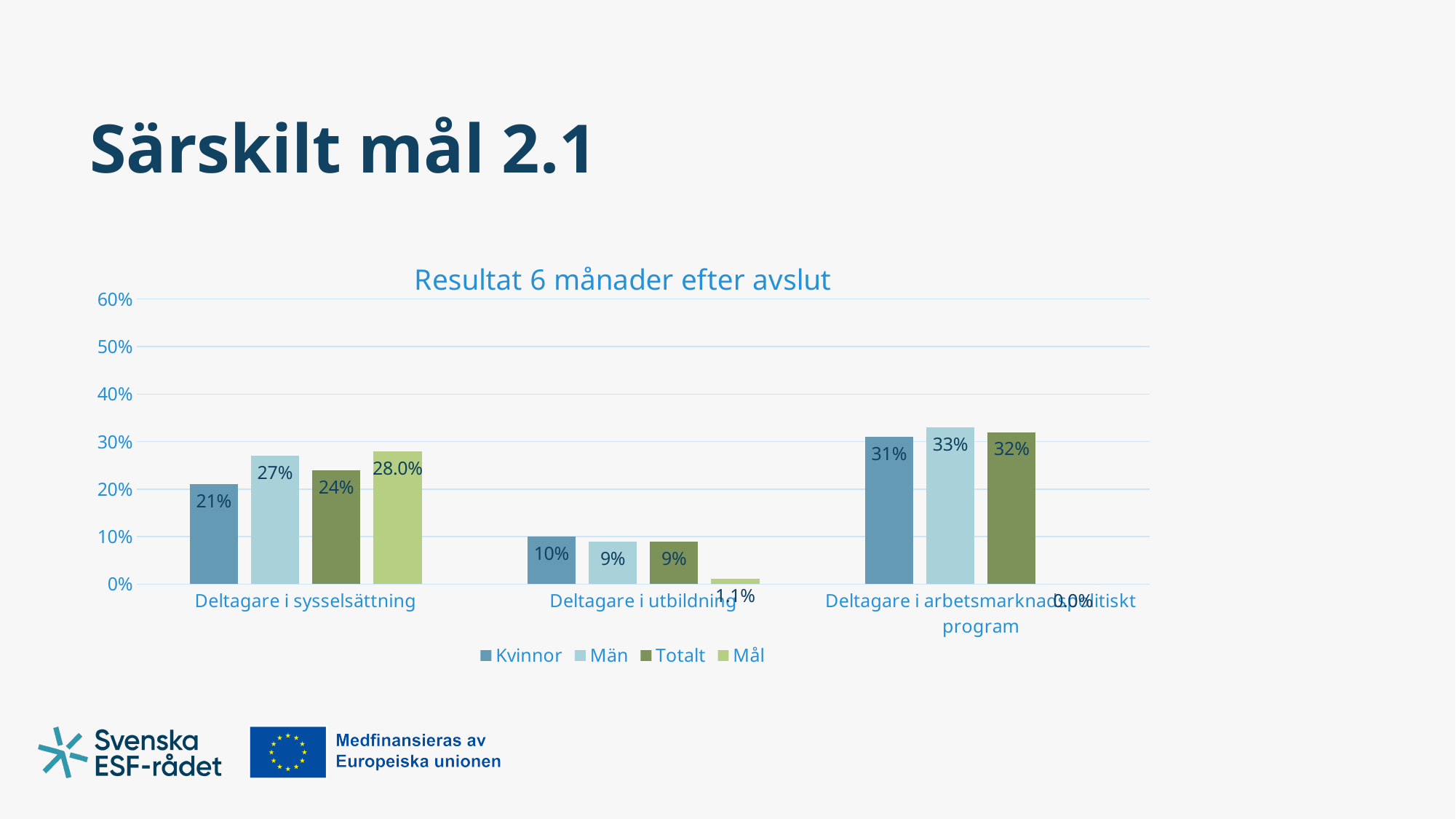
Is the value for Totalt in the category Deltagare i arbetsmarknadspolitiskt program greater or less than 30%? greater What kind of chart is shown on the slide? bar chart Which category has the highest value for Totalt? Deltagare i arbetsmarknadspolitiskt program What is the value for Mål in the category Deltagare i sysselsättning? 28.0% What is the difference between the Män value and the Kvinnor value in the category Deltagare i sysselsättning? 6% Which is larger in the category Deltagare i utbildning: the value for Kvinnor or the value for Män? Kvinnor What is the title of the chart? Resultat 6 månader efter avslut What is the value for Män in the category Deltagare i arbetsmarknadspolitiskt program? 33% How many series does the legend list? 4 What is the value for Kvinnor in the category Deltagare i sysselsättning? 21% How many categories are shown on the x axis? 3 What is the value for Mål in the category Deltagare i utbildning? 1.1%